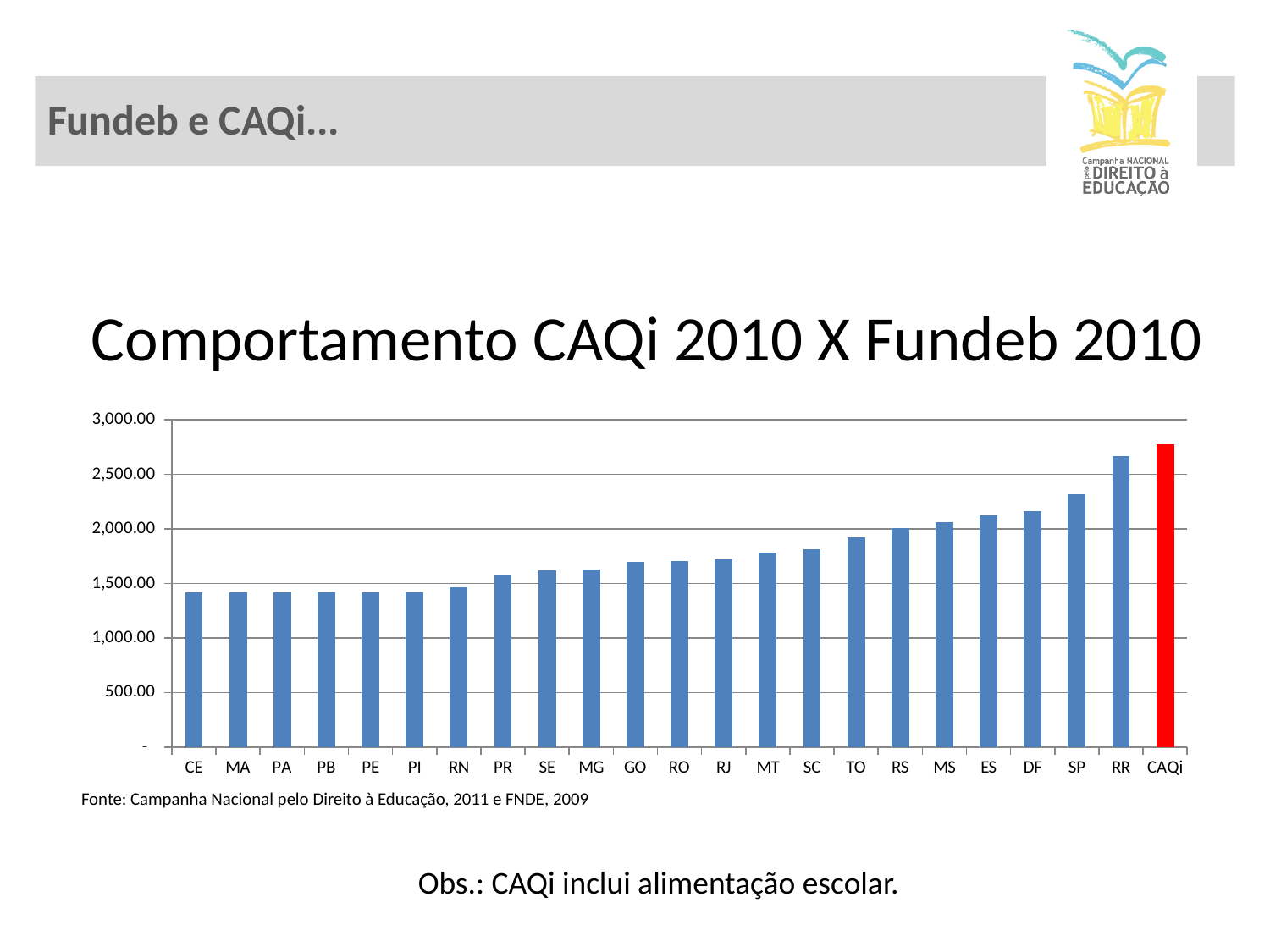
How many categories are plotted along the x axis of the chart? 23 Which is larger, the value for RR or the value for SP? RR Which is larger, the value for CAQi or the value for RR? CAQi Is the value for RR greater or less than 2,500.00? greater Is the value for CE greater or less than 1,500.00? less What colour is the bar for CAQi? red Is the value for PR greater or less than 1,500.00? greater Do the bar values generally rise or fall from left to right along the x axis? rise Which category has the highest bar in the chart? CAQi What kind of chart is shown on the slide? bar chart